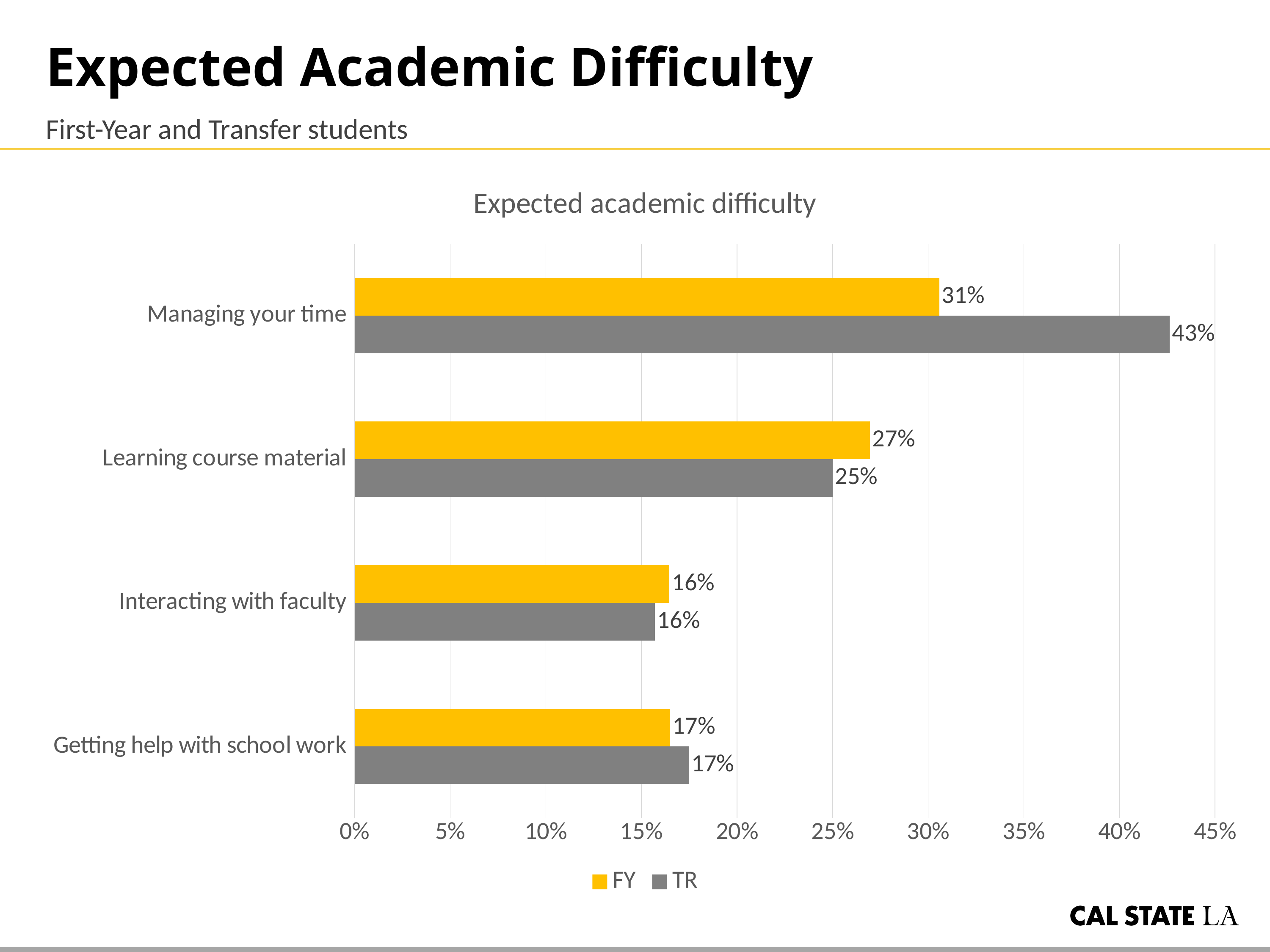
Which category has the highest TR value? Managing your time What is the FY value for Learning course material? 27% For Learning course material, which is larger, the FY value or the TR value? FY What is the TR value for Managing your time? 43% Is the FY value for Managing your time greater or less than 30%? greater Which category has the lowest FY value? Interacting with faculty What is the FY value for Interacting with faculty? 16% How many categories are shown on the chart? 4 What is the difference between the TR and FY values for Managing your time? 12% What kind of chart is shown on the slide? Bar chart How many series does the legend list? 2 What is the TR value for Getting help with school work? 17%